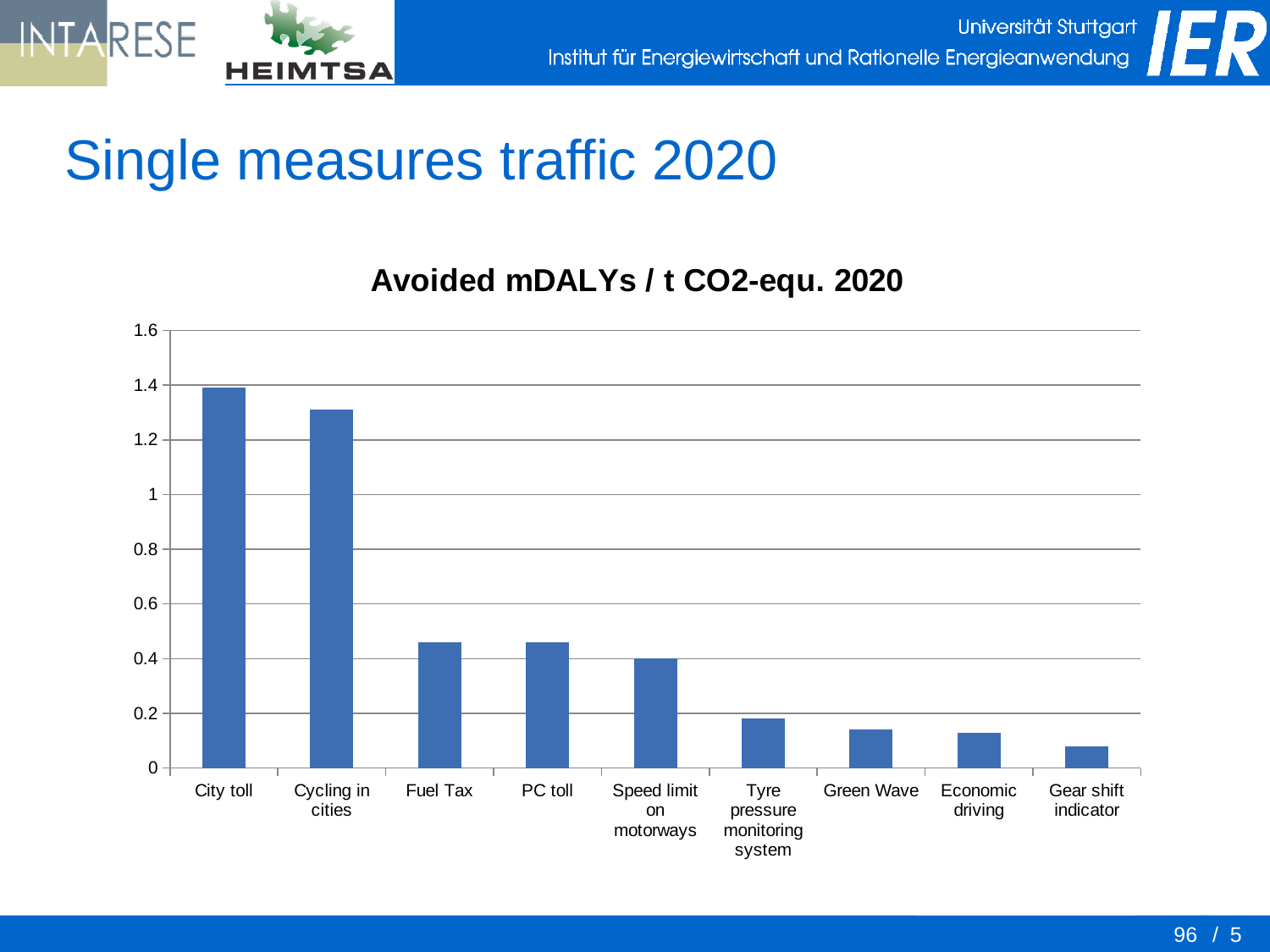
Is the value for City toll greater or less than 1.2? greater What kind of chart is shown on the slide? bar chart Is the value for Green Wave greater or less than 0.2? less Which measure has the highest value of avoided mDALYs / t CO2-equ.? City toll How many measures (categories) are plotted in the chart? 9 Which has a larger value, Speed limit on motorways or Tyre pressure monitoring system? Speed limit on motorways Is the value for Tyre pressure monitoring system greater or less than 0.2? less What is the title of the chart? Avoided mDALYs / t CO2-equ. 2020 Which has a larger value, City toll or Cycling in cities? City toll Do the values rise or fall moving from left to right along the x axis? fall Which measure has the lowest value of avoided mDALYs / t CO2-equ.? Gear shift indicator